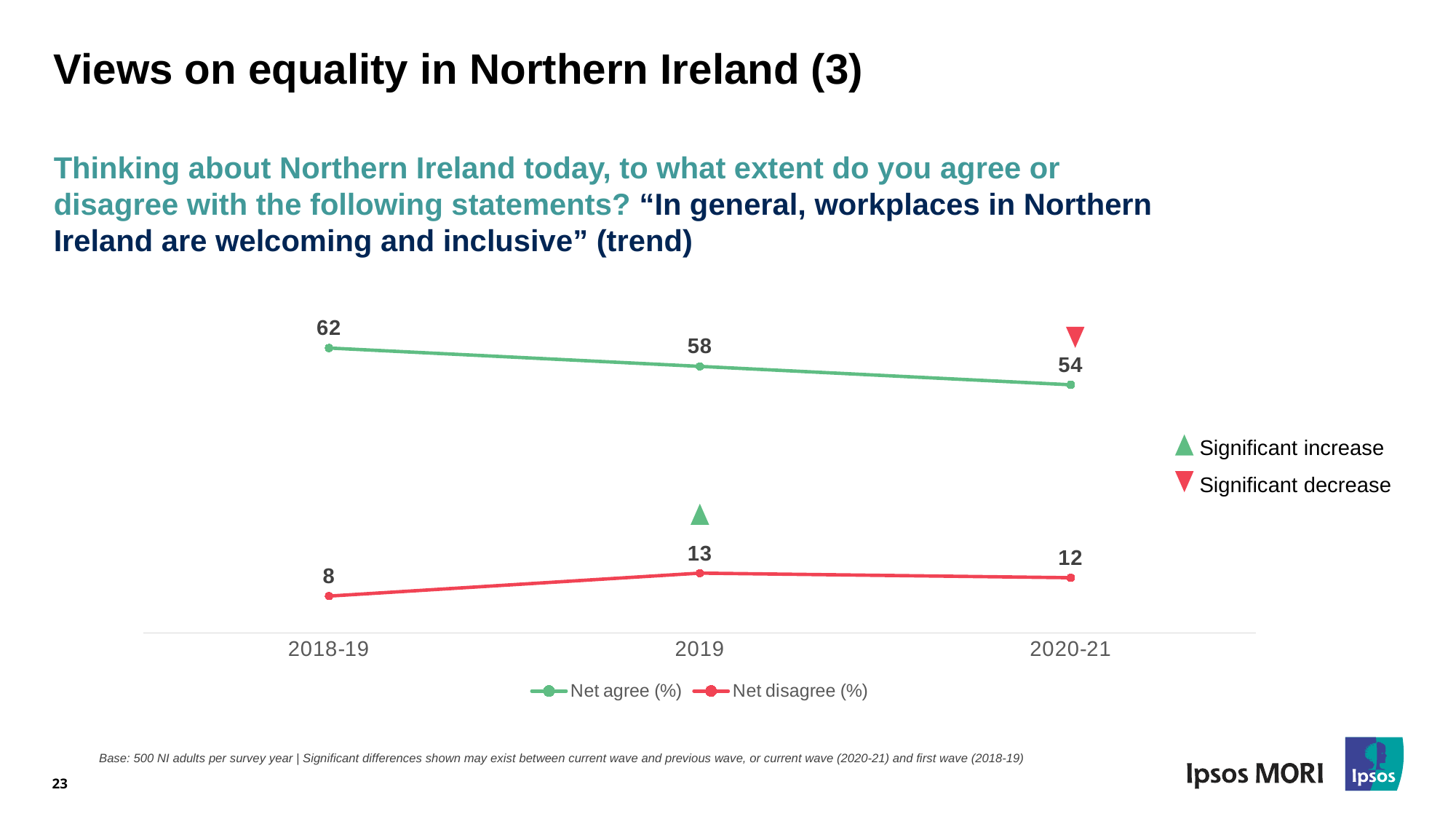
In which survey year is Net agree (%) highest? 2018-19 What is the Net agree (%) value for 2018-19? 62 In which survey year is Net disagree (%) lowest? 2018-19 What is the Net disagree (%) value for 2020-21? 12 How many series does the legend list? 2 What is the Net disagree (%) value for 2019? 13 What is the difference between Net agree (%) in 2018-19 and 2020-21? 8 What kind of chart is shown on the slide? Line chart Which is larger in 2019: Net agree (%) or Net disagree (%)? Net agree (%) What is the Net agree (%) value for 2020-21? 54 Does Net agree (%) rise or fall from 2018-19 to 2020-21? Fall How many survey years are shown on the x axis? 3